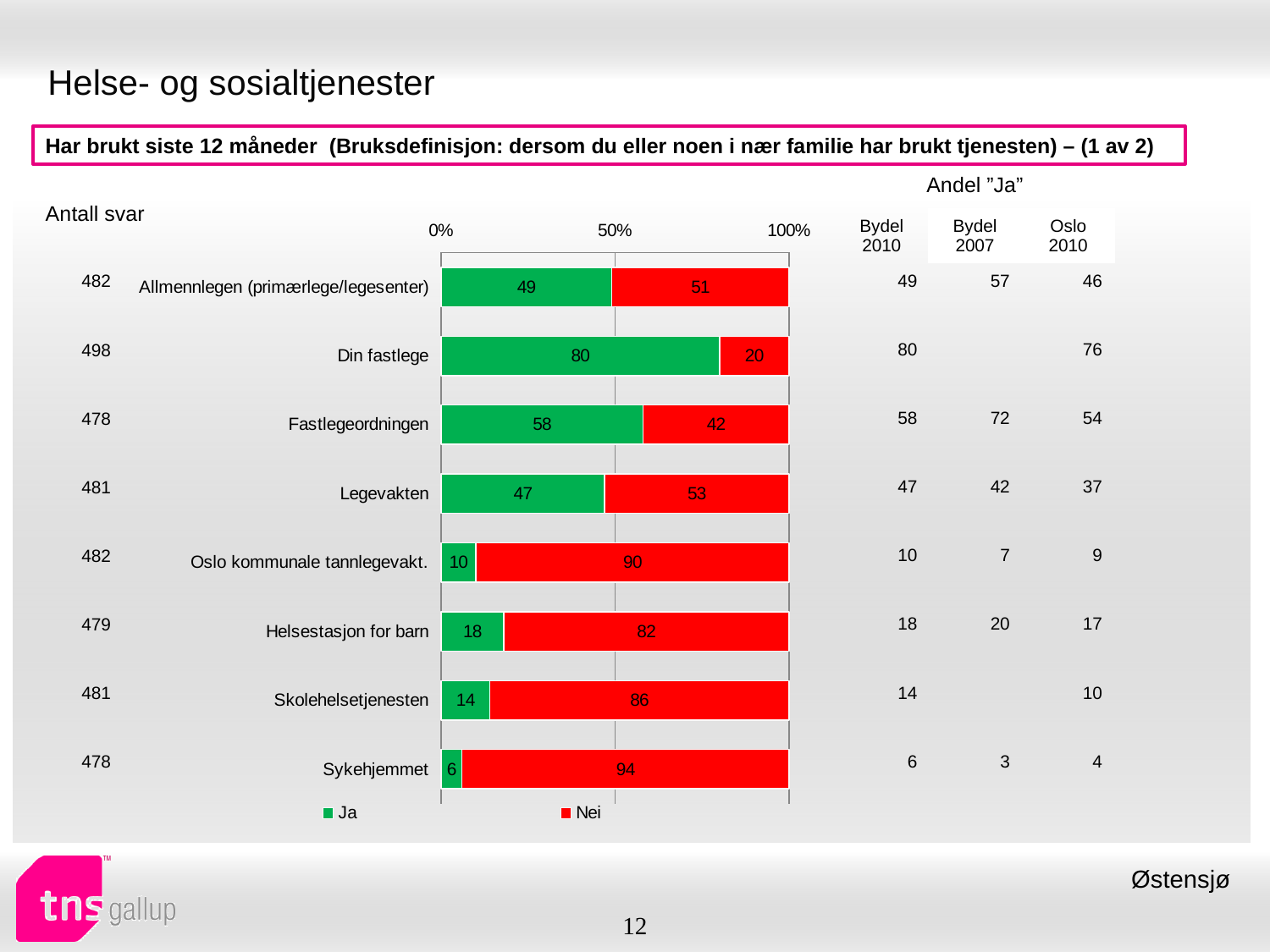
Which category has the lowest "Ja" value? Sykehjemmet Which is larger: the "Ja" value for Fastlegeordningen or the "Ja" value for Allmennlegen (primærlege/legesenter)? Fastlegeordningen Which colour represents the "Nei" series in the chart? Red What is the "Ja" value for Din fastlege? 80 How many categories are shown in the chart? 8 What is the total of the stacked bar for Helsestasjon for barn? 100 Which category has the highest "Ja" value? Din fastlege What is the difference between the "Nei" value for Sykehjemmet and the "Nei" value for Skolehelsetjenesten? 8 What kind of chart is shown on the slide? Stacked bar chart What is the "Ja" value for Legevakten? 47 What is the "Nei" value for Oslo kommunale tannlegevakt.? 90 How many series does the legend list? 2